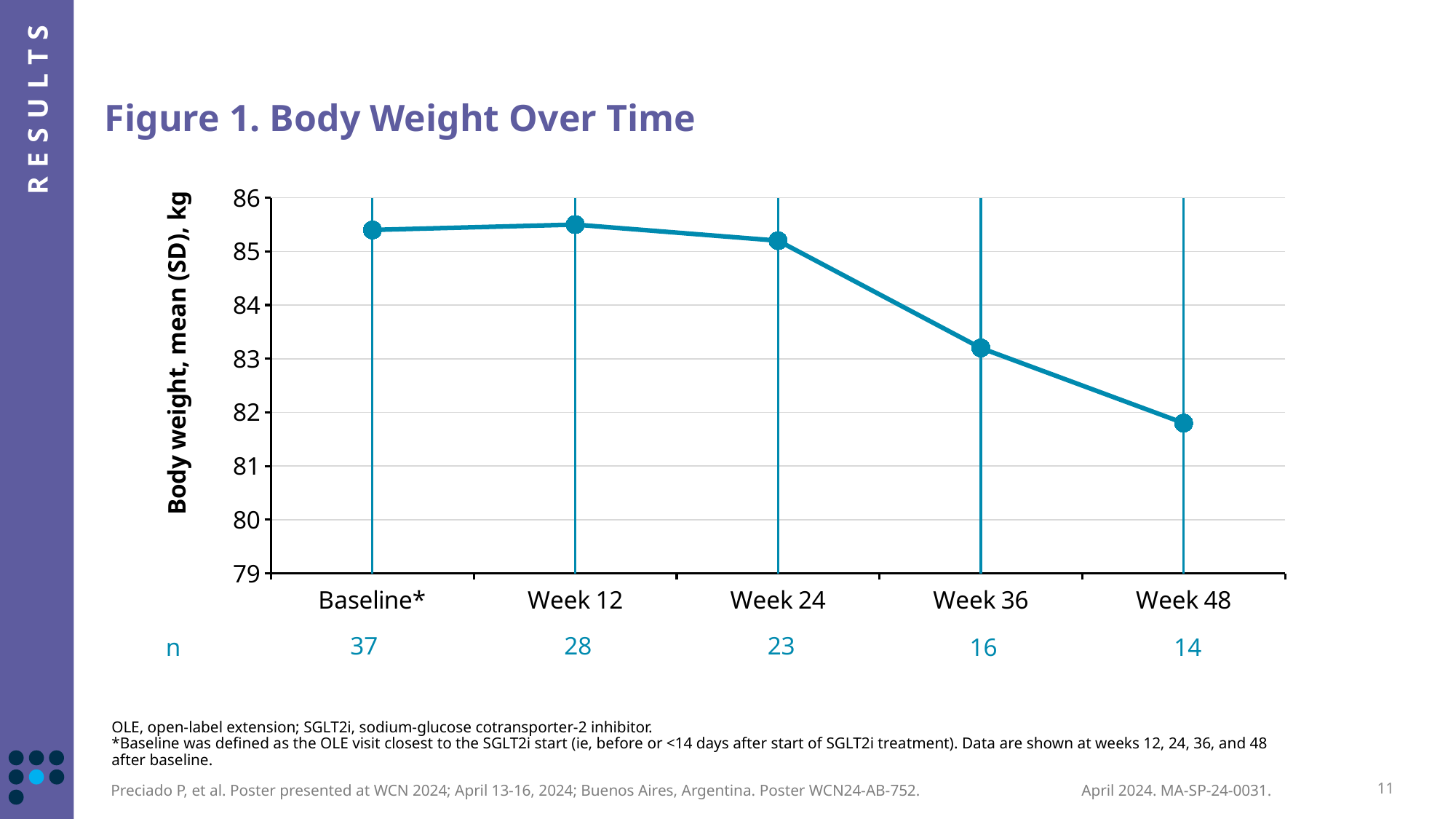
Which is larger, the body weight at Week 24 or at Week 36? Week 24 Is the body weight at Week 36 greater or less than 84 kg? less Is the body weight at Week 48 greater or less than 83 kg? less At which time point is body weight lowest? Week 48 What is the n at Week 48? 14 Does body weight rise or fall from Week 24 to Week 48? fall How many time points are plotted on the chart? 5 Is the body weight at Baseline* greater or less than 85 kg? greater What is the label of the y axis? Body weight, mean (SD), kg What is the title of the figure? Figure 1. Body Weight Over Time What is the n at Baseline*? 37 What kind of chart is shown on the slide? line chart